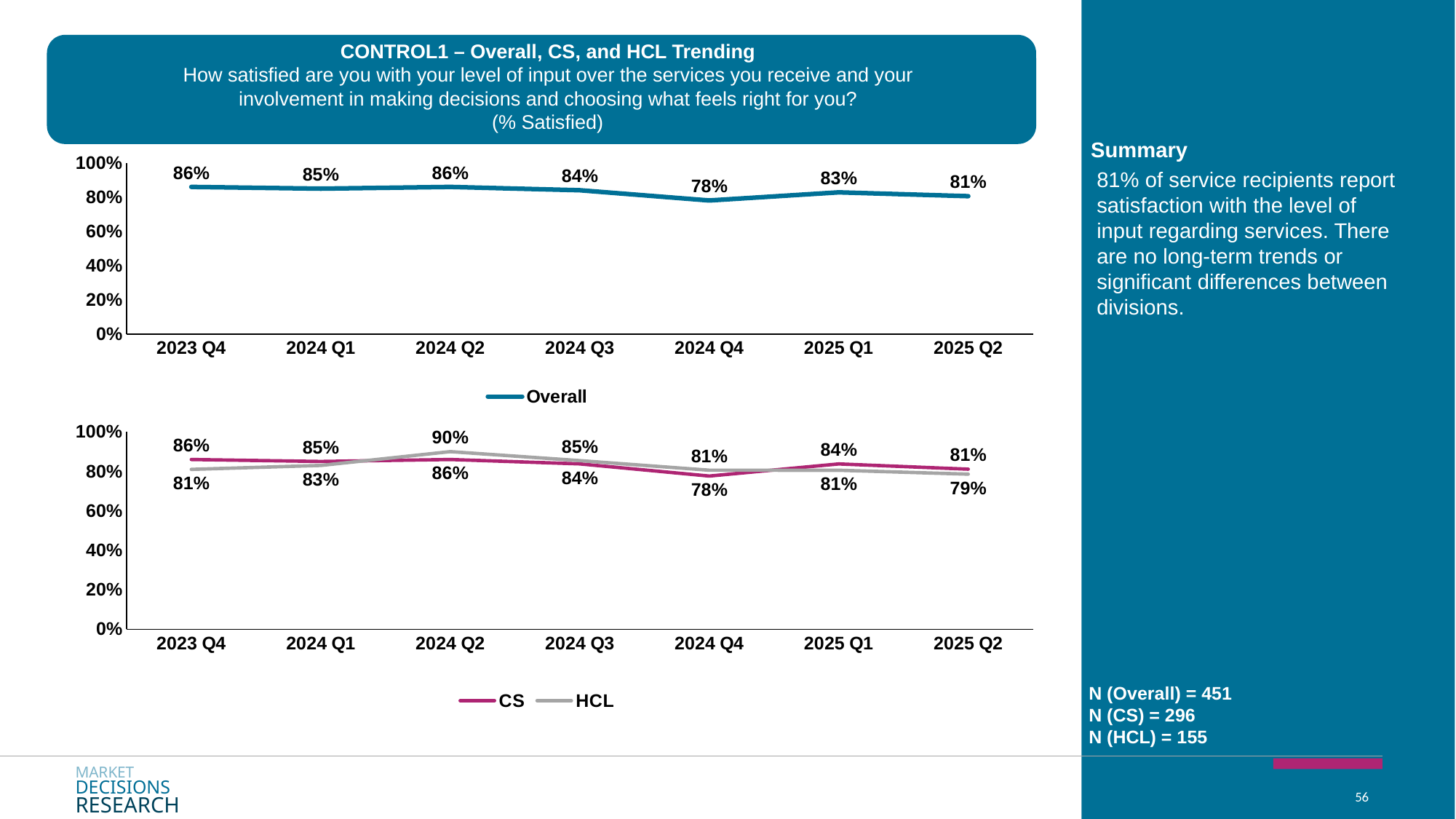
In the top chart (Overall), how many quarters are plotted on the x axis? 7 In the bottom chart, what is the difference between the CS and HCL values in 2023 Q4? 5 percentage points How many series does the legend of the bottom chart list? 2 In the bottom chart, which series has the higher value in 2025 Q1, CS or HCL? CS In the bottom chart, what is the HCL value for 2024 Q2? 90% In the top chart (Overall), which quarter has the lowest value? 2024 Q4 In the bottom chart, what is the CS value for 2024 Q4? 78% What kind of chart is the top chart? Line chart In the top chart (Overall), what is the value for 2025 Q2? 81% In the bottom chart, is the HCL value for 2025 Q2 greater or less than 60%? greater In the top chart (Overall), what is the difference between the 2023 Q4 value and the 2024 Q4 value? 8 percentage points In the top chart (Overall), what is the value for 2024 Q4? 78%